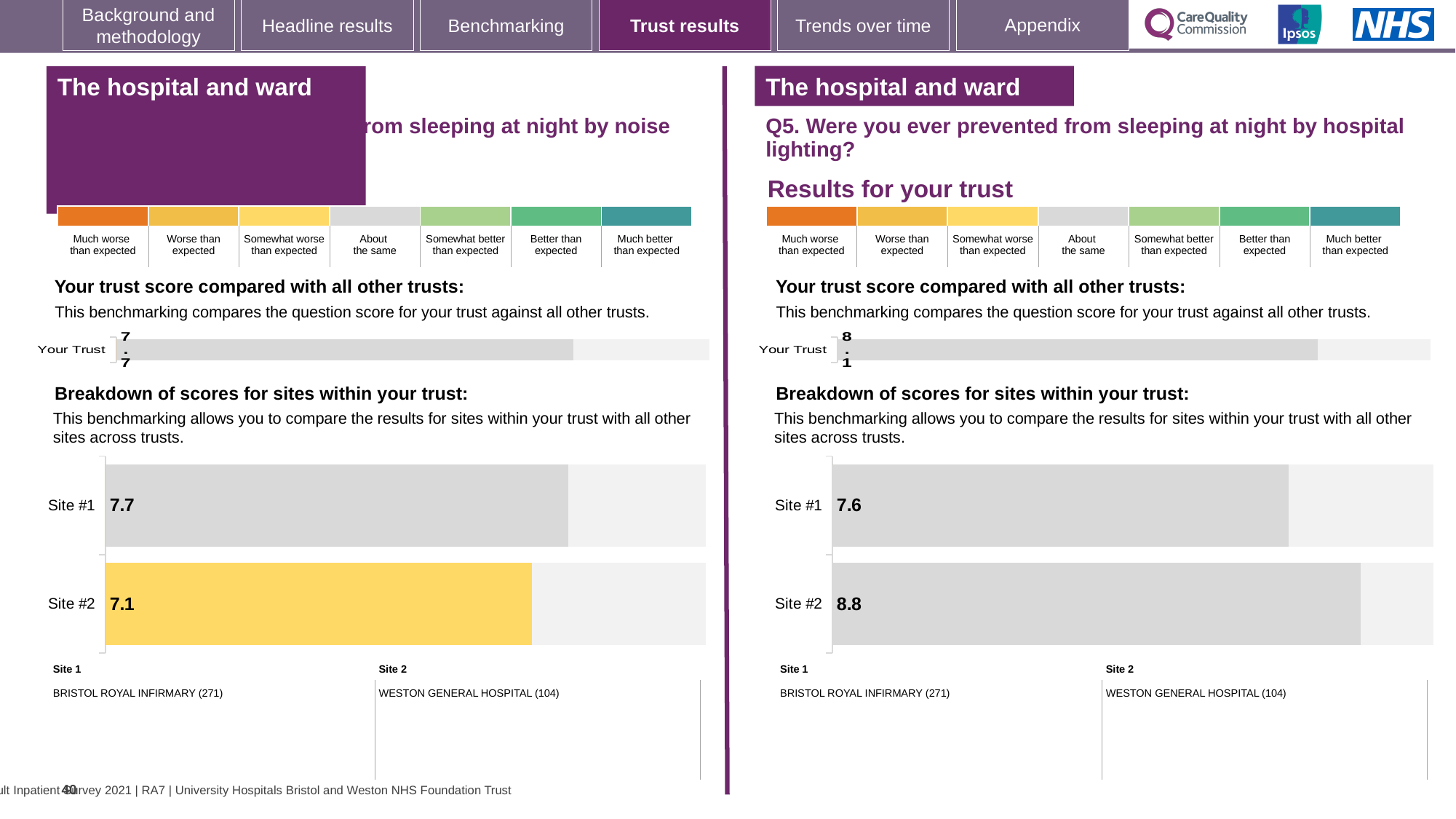
How many sites are shown on the right-hand site breakdown chart (Q5, hospital lighting)? 2 On the right-hand site breakdown chart (Q5, hospital lighting), what is the score for Site #1? 7.6 On the left-hand site breakdown chart, what is the score for Site #2? 7.1 On the left-hand site breakdown chart, what is the score for Site #1? 7.7 On the left-hand site breakdown chart, which site has the higher score? Site #1 On the left-hand site breakdown chart, what is the difference between the Site #1 and Site #2 scores? 0.6 What type of chart is used for the site breakdown on the left-hand side of the slide? Bar chart On the left-hand 'Your trust score compared with all other trusts' chart, what is the score shown for Your Trust? 7.7 On the right-hand site breakdown chart (Q5, hospital lighting), what is the score for Site #2? 8.8 On the right-hand site breakdown chart (Q5, hospital lighting), what is the difference between the Site #2 and Site #1 scores? 1.2 On the right-hand 'Your trust score compared with all other trusts' chart (Q5, hospital lighting), what is the score shown for Your Trust? 8.1 On the right-hand site breakdown chart (Q5, hospital lighting), which site has the lower score? Site #1